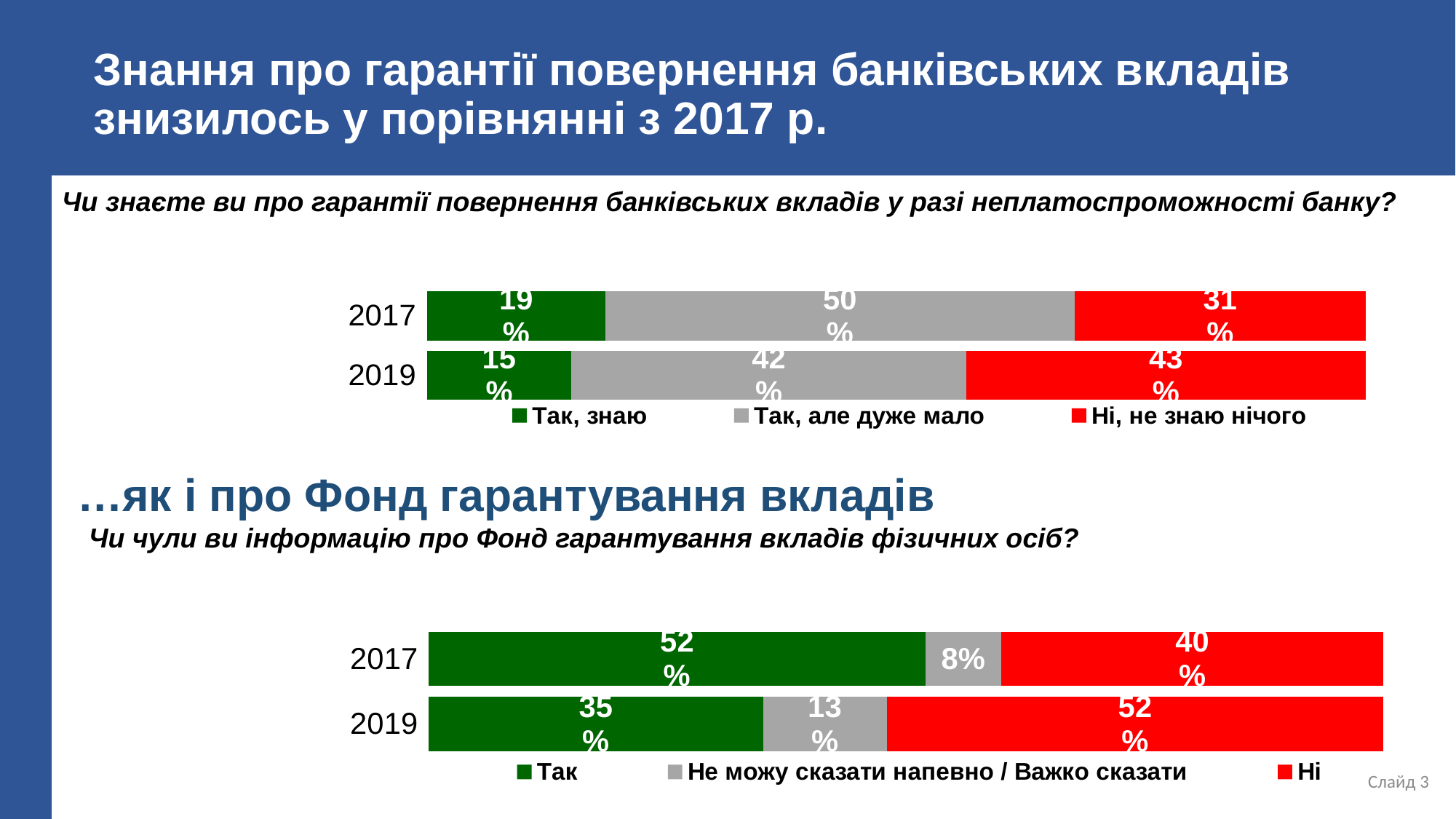
In the bottom chart, which year has the larger "Ні" share, 2017 or 2019? 2019 What type of chart is the bottom chart? Stacked bar chart In the top chart, which year has the larger share for "Так, знаю", 2017 or 2019? 2017 In the bottom chart, which colour represents the "Ні" answer? Red How many series does the legend of the top chart list? 3 How many years (categories) are shown in the bottom chart? 2 In the top chart, what percentage answered "Ні, не знаю нічого" in 2019? 43% In the top chart, what is the difference between the "Так, але дуже мало" share in 2017 and in 2019? 8 percentage points In the bottom chart, what percentage answered "Не можу сказати напевно / Важко сказати" in 2017? 8% In the bottom chart, what percentage answered "Так" in 2019? 35% In the top chart, what percentage answered "Так, знаю" in 2017? 19% In the bottom chart, by how many percentage points did the "Ні" share change from 2017 to 2019? 12 percentage points